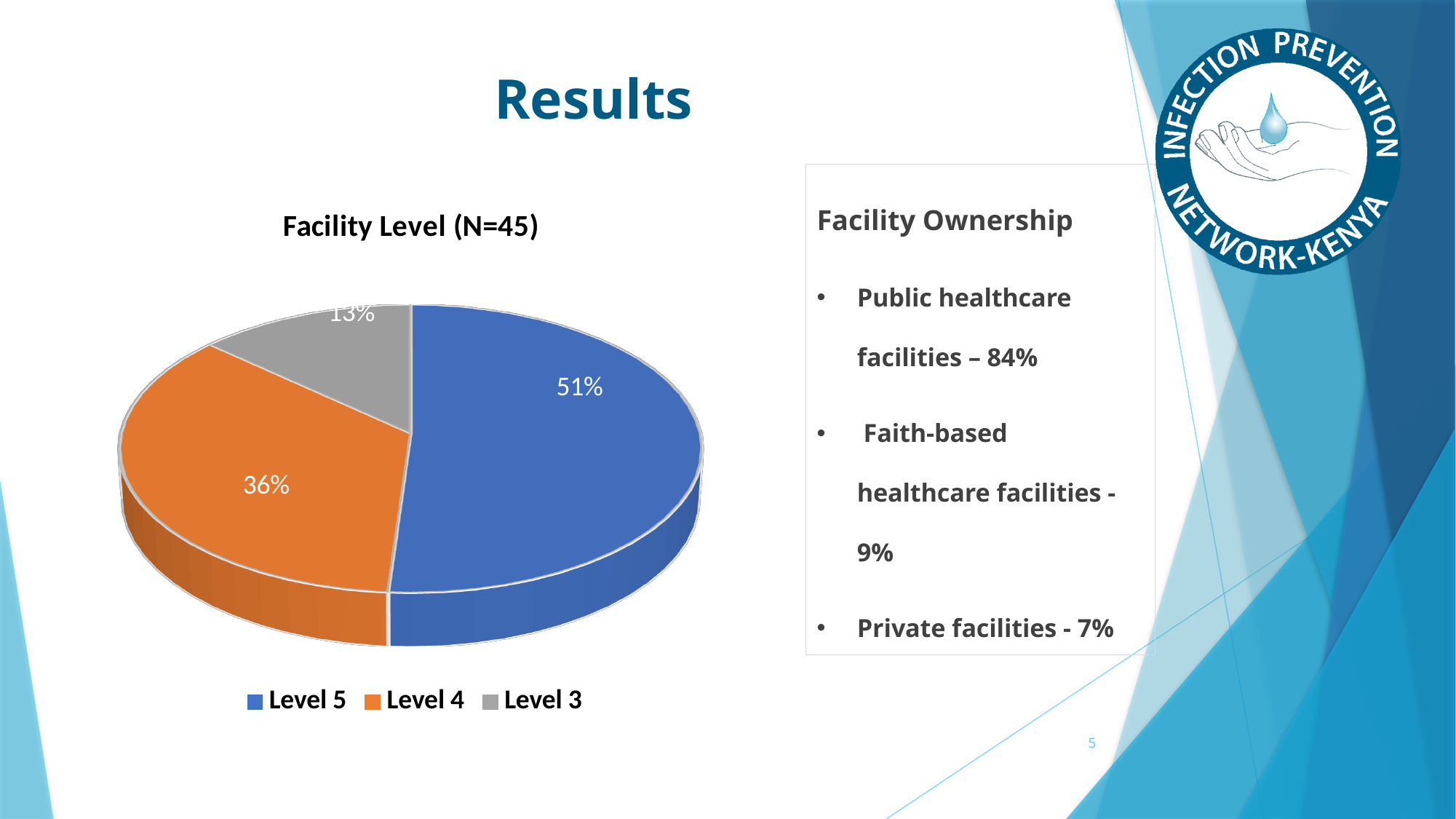
Which colour represents Level 4 in the legend? Orange What share of the pie does Level 5 represent? 51% What kind of chart is shown on the slide? Pie chart Which facility level has the smallest slice of the pie? Level 3 Which facility level has the largest slice of the pie? Level 5 What is the difference in percentage points between the Level 5 and Level 4 slices? 15 How many categories are shown in the pie chart? 3 What is the title of the chart? Facility Level (N=45) What share of the pie does Level 3 represent? 13% What share of the pie does Level 4 represent? 36% Which slice is larger, Level 4 or Level 3? Level 4 What is the difference in percentage points between the Level 4 and Level 3 slices? 23